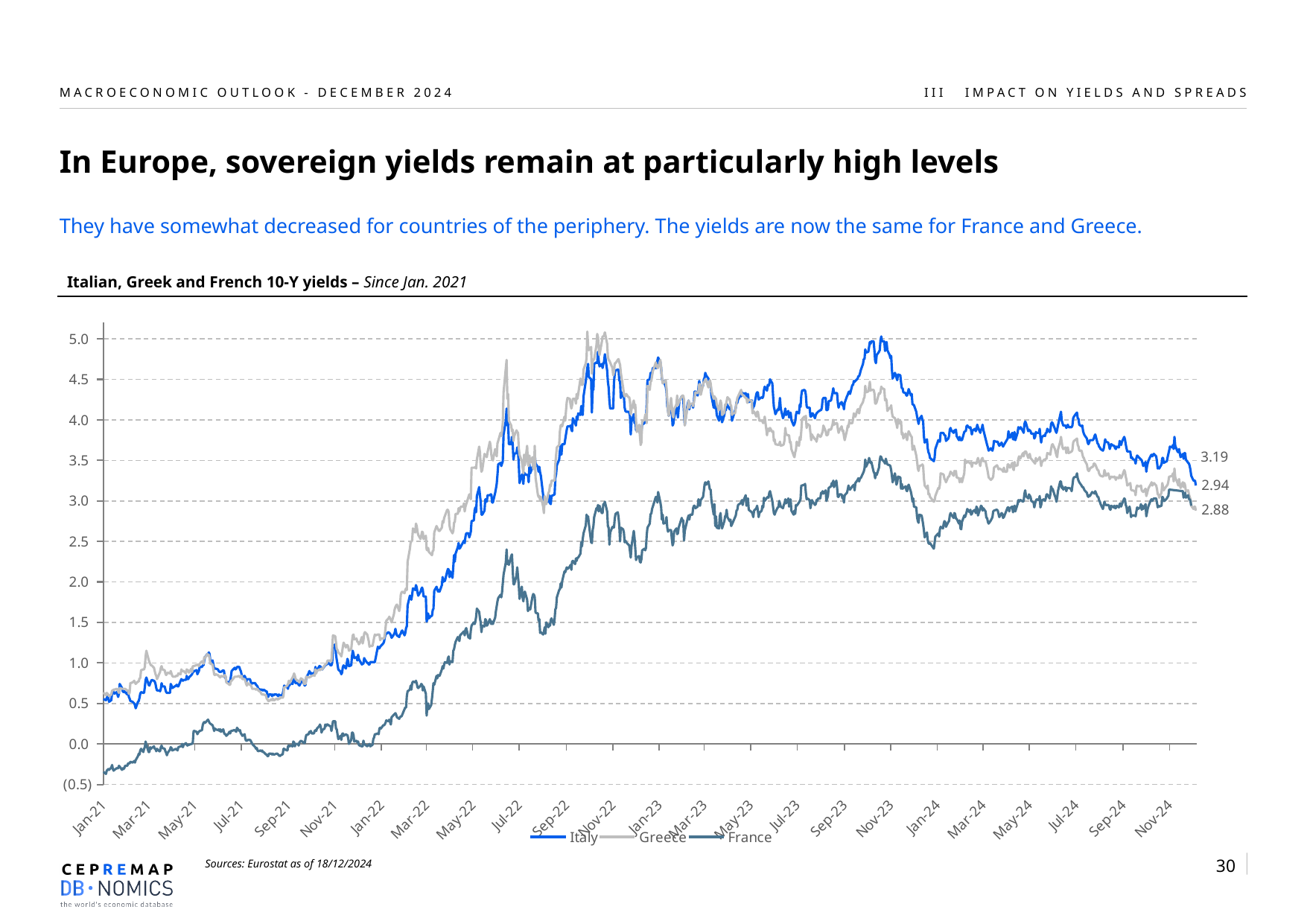
What is the latest value shown for Greece at the end of the series? 2.94 Does the France series rise or fall overall from Jan-21 to Nov-24? rise Is the value for France in Jan-21 greater or less than 0.0? less Is the peak value for Italy around Nov-23 greater or less than 4.5? greater How many series does the legend list? 3 Which series has the highest value at the end of the chart? Italy What is the difference between the latest values for Italy and France? 0.31 What is the difference between the latest values for Italy and Greece? 0.25 What kind of chart is shown on the slide? line chart What is the latest value shown for France at the end of the series? 2.88 Which countries are listed in the chart legend? Italy, Greece, France What is the latest value shown for Italy at the end of the series? 3.19